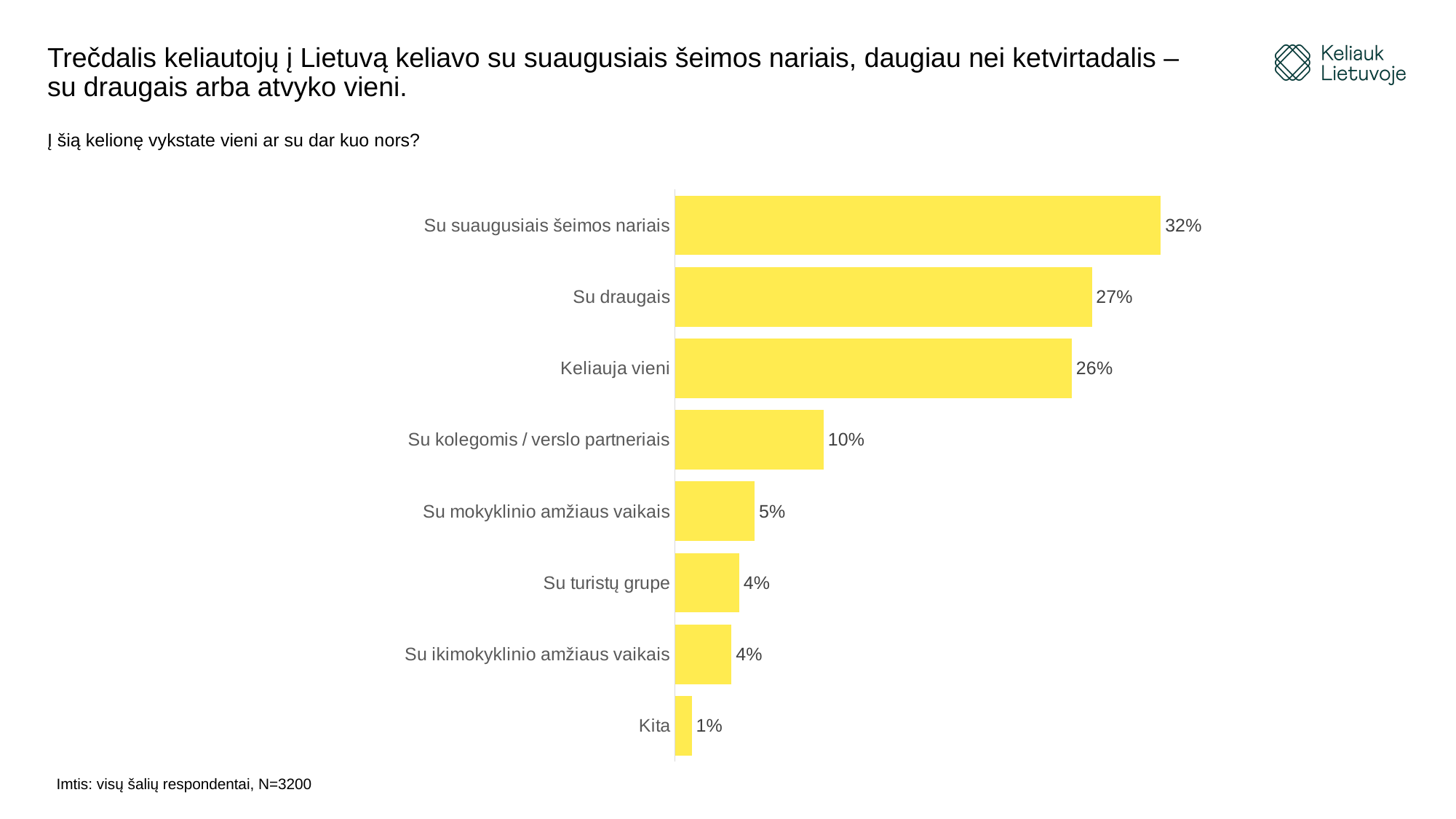
Which category has the lowest value? Kita Which category has the highest value? Su suaugusiais šeimos nariais What question is the chart based on, as shown above the chart? Į šią kelionę vykstate vieni ar su dar kuo nors? How many categories are shown in the chart? 8 What is the difference between the values for "Su draugais" and "Su kolegomis / verslo partneriais"? 17% What is the value for "Keliauja vieni"? 26% What is the value for "Su mokyklinio amžiaus vaikais"? 5% What is the value for "Su kolegomis / verslo partneriais"? 10% What is the value for "Su suaugusiais šeimos nariais"? 32% What is the difference between the values for "Su suaugusiais šeimos nariais" and "Su draugais"? 5% Which is larger, the value for "Su draugais" or the value for "Keliauja vieni"? Su draugais What kind of chart is shown on the slide? Bar chart